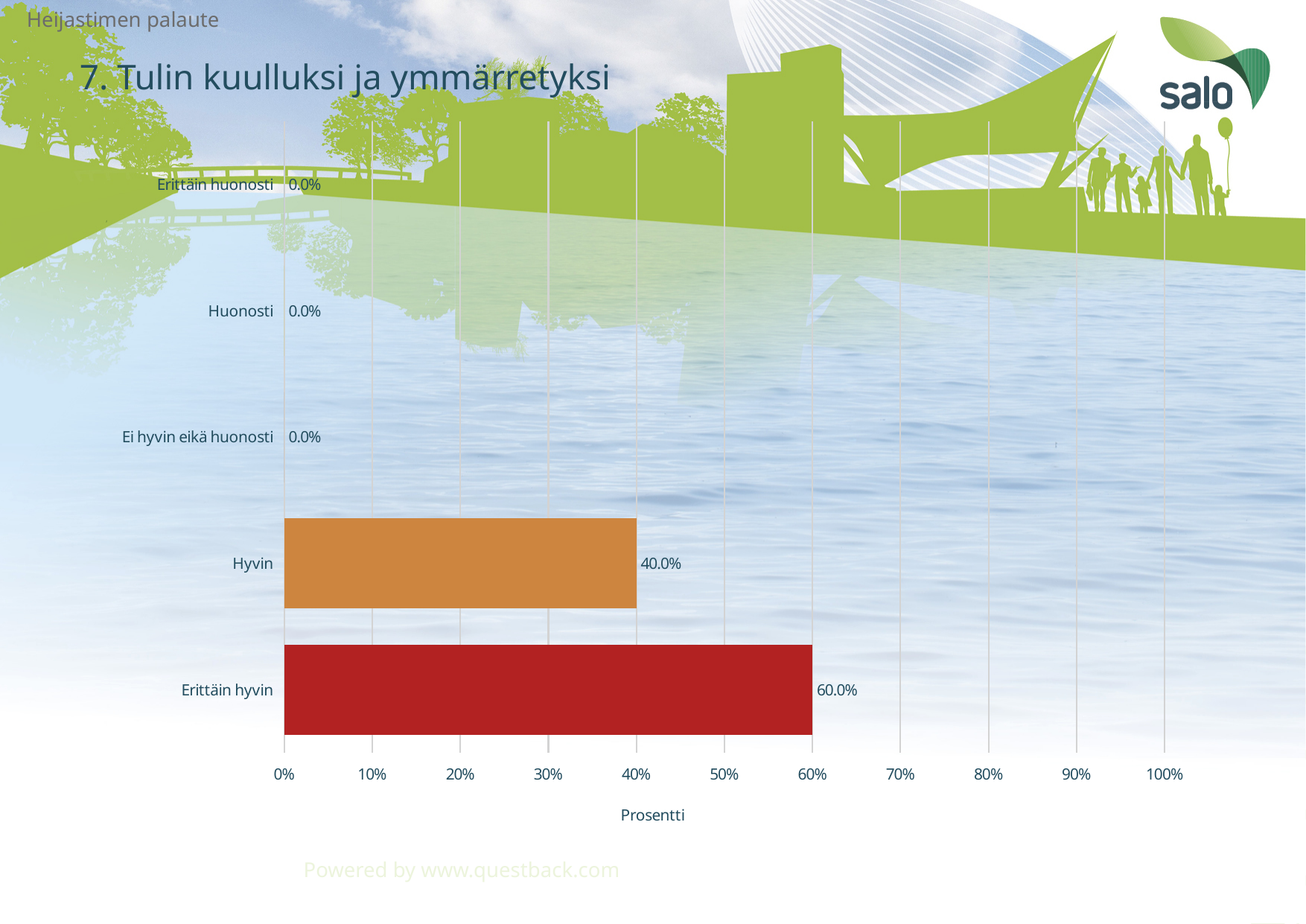
What is the title of the chart? 7. Tulin kuulluksi ja ymmärretyksi How many categories are shown in the chart? 5 What is the difference between the values for "Erittäin hyvin" and "Hyvin"? 20.0% What is the value for "Hyvin"? 40.0% What is the value for "Erittäin hyvin"? 60.0% What kind of chart is shown on the slide? bar chart What is the label of the horizontal axis? Prosentti What is the value for "Ei hyvin eikä huonosti"? 0.0% Which category has the highest value? Erittäin hyvin Is the value for "Erittäin hyvin" greater or less than 50%? greater What is the value for "Huonosti"? 0.0% Which is larger, the value for "Hyvin" or the value for "Erittäin hyvin"? Erittäin hyvin